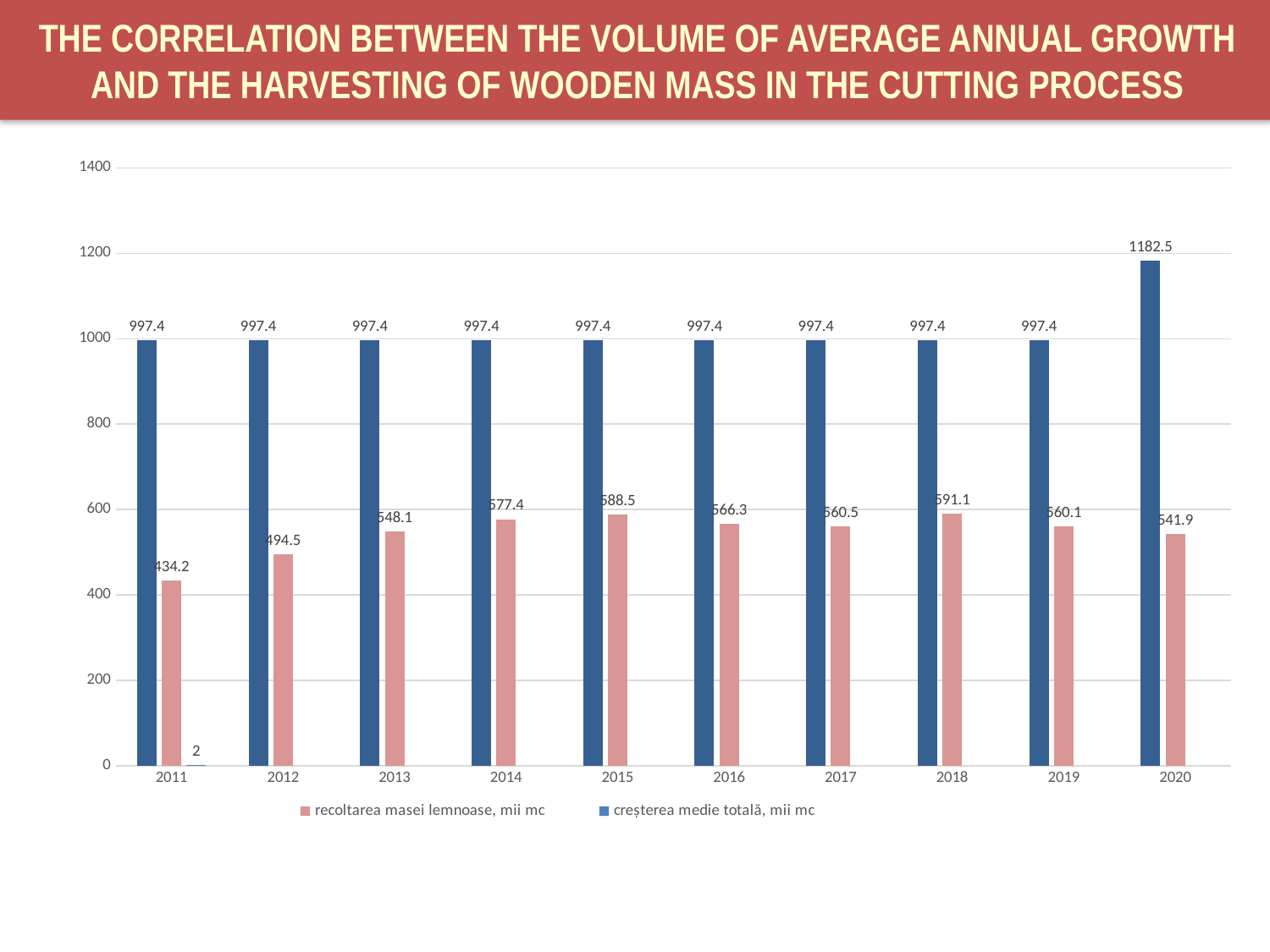
What is the value of 'recoltarea masei lemnoase, mii mc' for 2015? 588.5 Does 'recoltarea masei lemnoase, mii mc' rise or fall from 2011 to 2015? rise What is the difference between 'creșterea medie totală, mii mc' and 'recoltarea masei lemnoase, mii mc' in 2020? 640.6 What is the value of 'recoltarea masei lemnoase, mii mc' for 2011? 434.2 How many years are shown on the x axis? 10 Which colour represents 'creșterea medie totală, mii mc' in the chart? blue How many series does the legend list? 2 What type of chart is shown on the slide? bar chart In which year is 'recoltarea masei lemnoase, mii mc' the highest? 2018 Which is larger in 2013: 'creșterea medie totală, mii mc' or 'recoltarea masei lemnoase, mii mc'? creșterea medie totală, mii mc In which year is 'recoltarea masei lemnoase, mii mc' the lowest? 2011 What is the value of 'creșterea medie totală, mii mc' for 2020? 1182.5